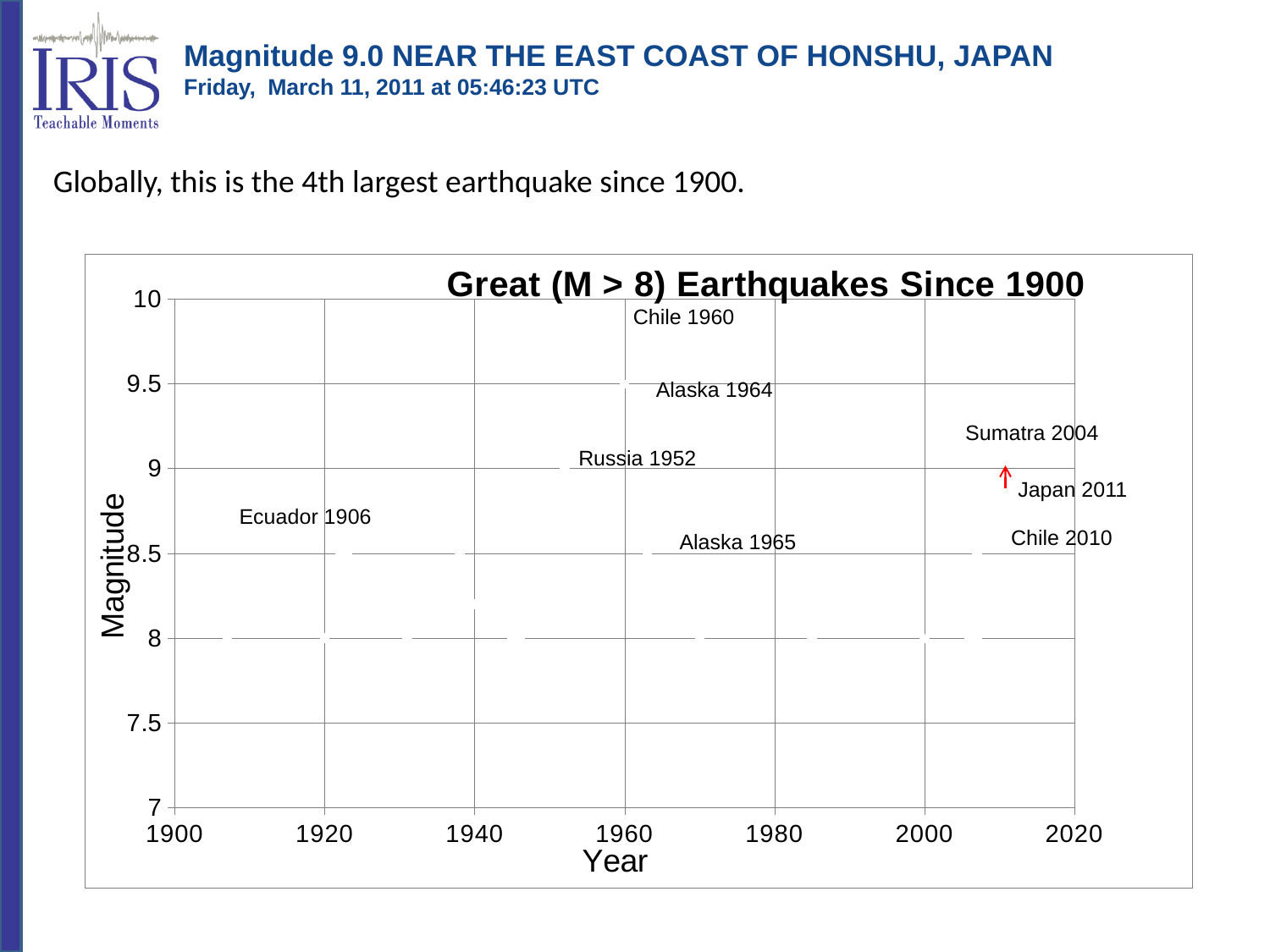
What is the title of the chart? Great (M > 8) Earthquakes Since 1900 What is the label of the vertical axis of the chart? Magnitude Is the magnitude of the Chile 1960 earthquake greater or less than 9? greater Which earthquake has the larger magnitude, Alaska 1964 or Chile 2010? Alaska 1964 Is the magnitude of the Alaska 1965 earthquake greater or less than 9? less What is the highest value shown on the Magnitude axis of the chart? 10 Is the magnitude of the Ecuador 1906 earthquake greater or less than 9? less Which labeled earthquake has the highest magnitude on the chart? Chile 1960 What kind of chart is shown on the slide? scatter plot How many earthquakes are labeled on the chart? 8 Which earthquake has the larger magnitude, Chile 1960 or Ecuador 1906? Chile 1960